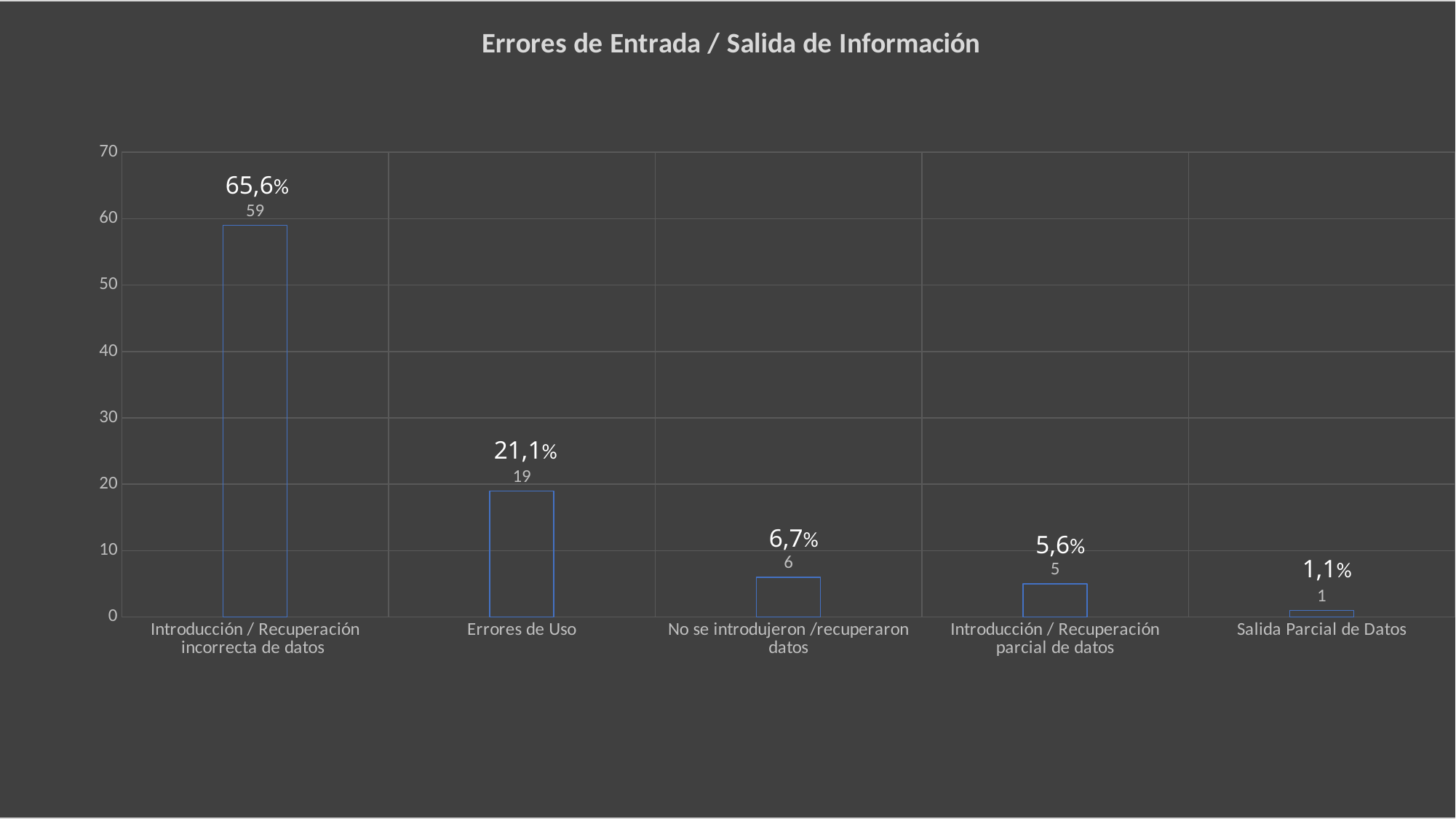
What is the title of the chart? Errores de Entrada / Salida de Información What is the count for "Errores de Uso"? 19 Which category has the lowest value? Salida Parcial de Datos What percentage is shown for "Introducción / Recuperación incorrecta de datos"? 65,6% Which is larger: the count for "No se introdujeron /recuperaron datos" or for "Introducción / Recuperación parcial de datos"? No se introdujeron /recuperaron datos What percentage is shown for "No se introdujeron /recuperaron datos"? 6,7% Which category has the highest value? Introducción / Recuperación incorrecta de datos What kind of chart is shown on the slide? bar chart What is the difference in count between "Introducción / Recuperación incorrecta de datos" and "Errores de Uso"? 40 Is the value for "Errores de Uso" greater or less than 20? less What is the count for "Salida Parcial de Datos"? 1 How many categories are shown on the x axis? 5